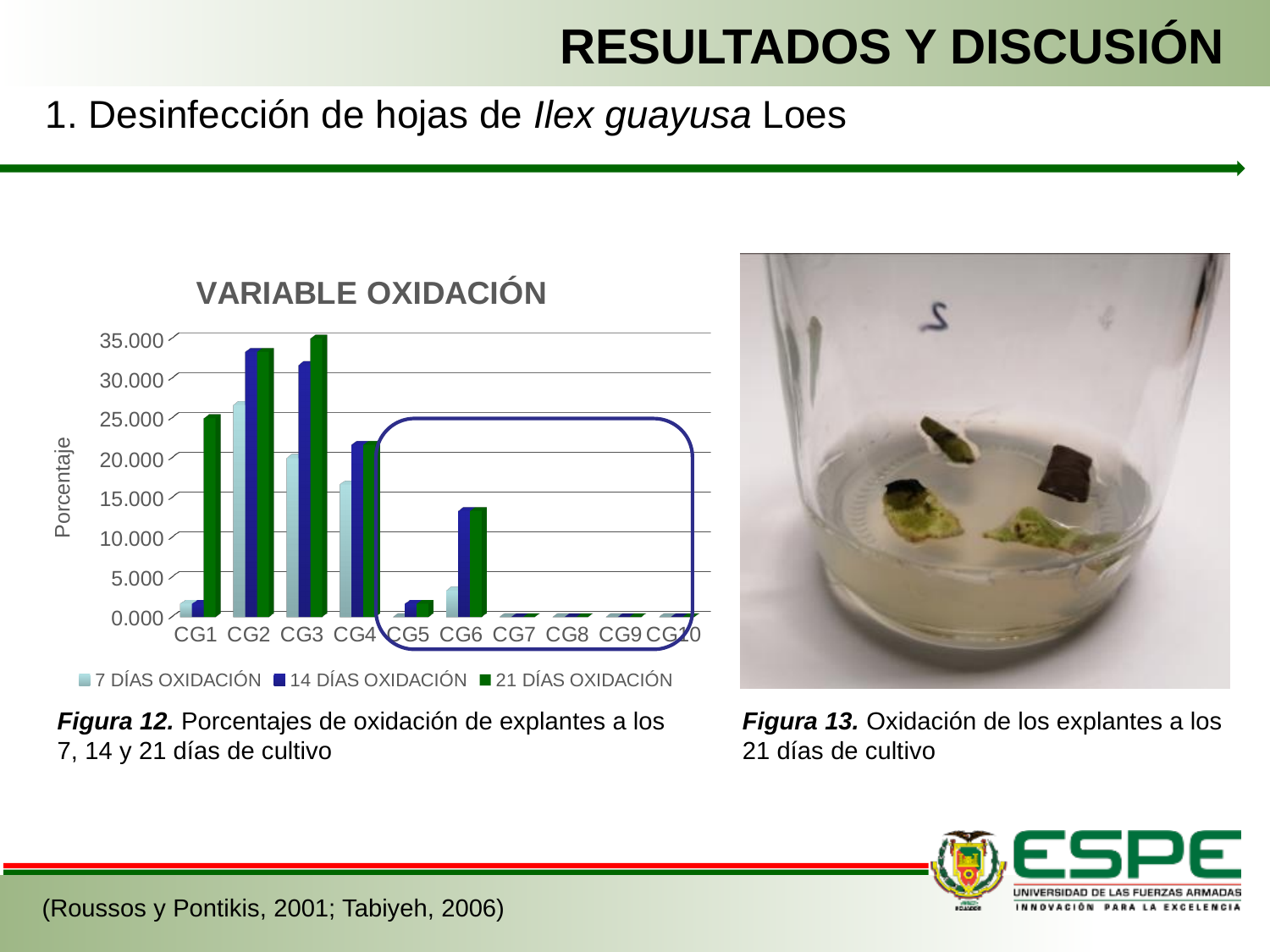
Which is larger for 7 DÍAS OXIDACIÓN: the value at CG2 or the value at CG3? CG2 What kind of chart is shown under the title VARIABLE OXIDACIÓN? bar chart Is the value for 7 DÍAS OXIDACIÓN at CG1 greater or less than 5.000? less What is the label of the y axis of the VARIABLE OXIDACIÓN chart? Porcentaje How many categories (CG groups) are shown on the x axis of the VARIABLE OXIDACIÓN chart? 10 Is the value for 14 DÍAS OXIDACIÓN at CG6 greater or less than 10.000? greater Which is larger at CG4: the value for 7 DÍAS OXIDACIÓN or the value for 21 DÍAS OXIDACIÓN? 21 DÍAS OXIDACIÓN Is the value for 14 DÍAS OXIDACIÓN at CG2 greater or less than 30.000? greater How many series does the legend of the VARIABLE OXIDACIÓN chart list? 3 Which category has the lowest value for 7 DÍAS OXIDACIÓN among CG1, CG2, CG3 and CG4? CG1 What is the title of the chart on the slide? VARIABLE OXIDACIÓN